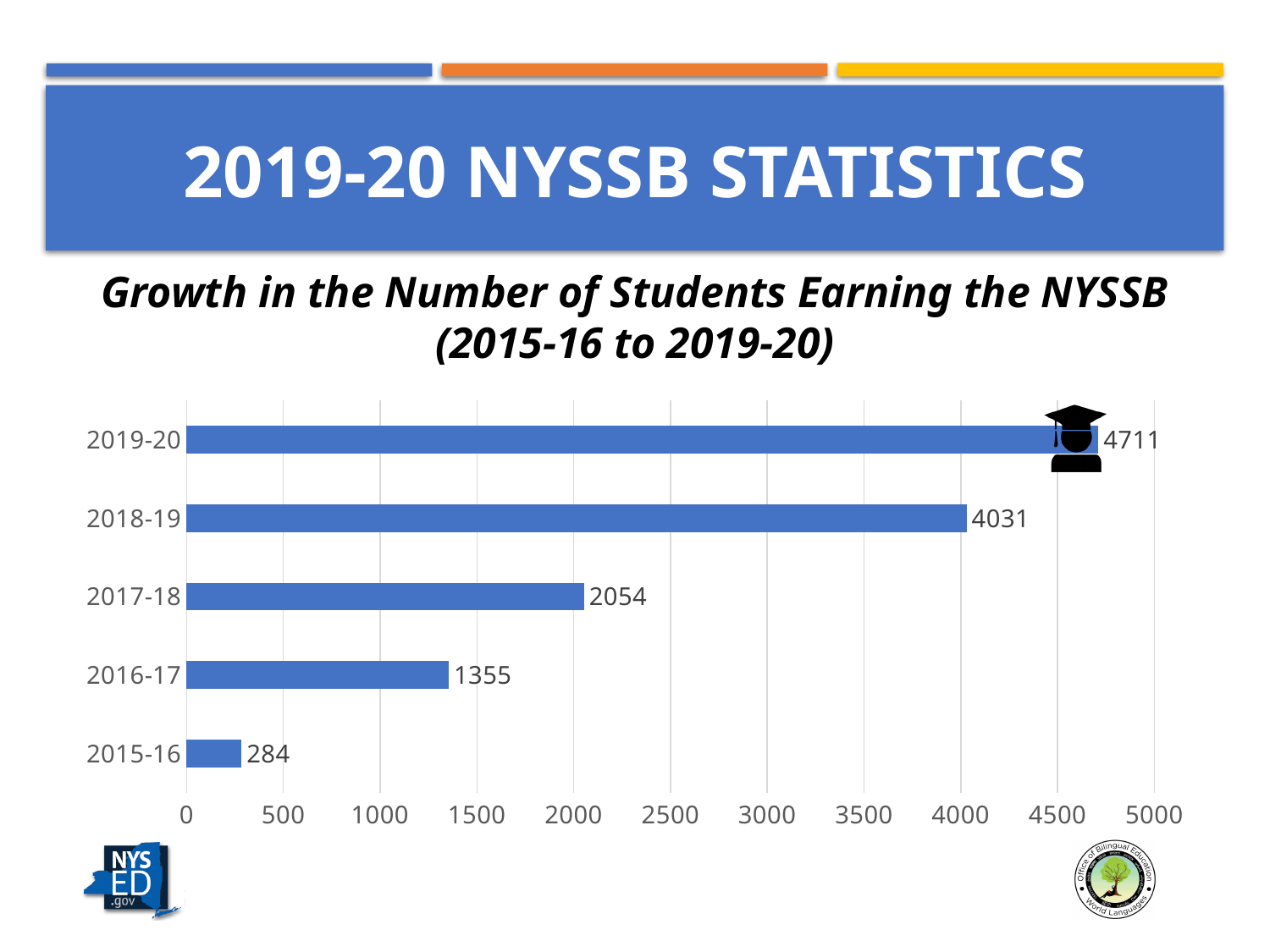
What is the title of the chart? Growth in the Number of Students Earning the NYSSB (2015-16 to 2019-20) Which is larger, the value for 2018-19 or the value for 2017-18? 2018-19 How many school years are shown in the chart? 5 What is the difference between the values for 2019-20 and 2018-19? 680 What is the value shown for 2015-16? 284 Is the value for 2017-18 greater or less than 2000? greater Which school year has the highest number of students earning the NYSSB? 2019-20 What kind of chart is shown on the slide? bar chart Which school year has the lowest number of students earning the NYSSB? 2015-16 How many students earned the NYSSB in 2019-20? 4711 What is the difference between the values for 2017-18 and 2016-17? 699 What is the value shown for 2016-17? 1355